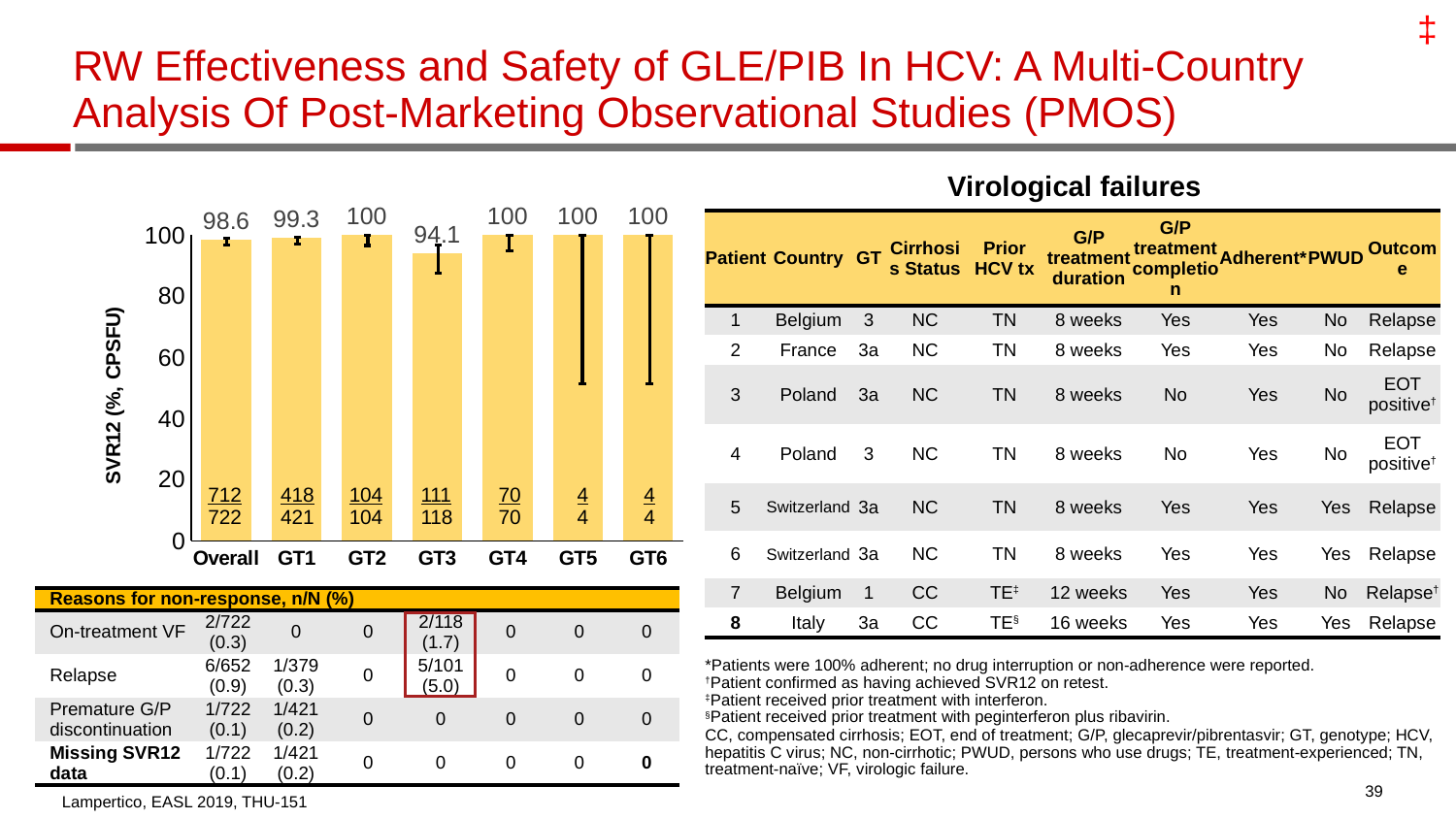
What is the SVR12 value for the Overall group? 98.6 What is the label of the y axis of the bar chart? SVR12 (%, CPSFU) Is the SVR12 value for GT3 greater or less than 80? greater How many categories are shown on the x axis of the bar chart? 7 Which genotype group has the lowest SVR12 value? GT3 What is the SVR12 value for GT1? 99.3 What is the SVR12 value for GT3? 94.1 What fraction (n/N) is printed on the GT3 bar? 111/118 What kind of chart is used to show SVR12 by genotype? bar chart What is the difference in SVR12 between GT1 and GT3? 5.2 What fraction (n/N) is printed on the Overall bar? 712/722 Which has a higher SVR12 value, Overall or GT1? GT1